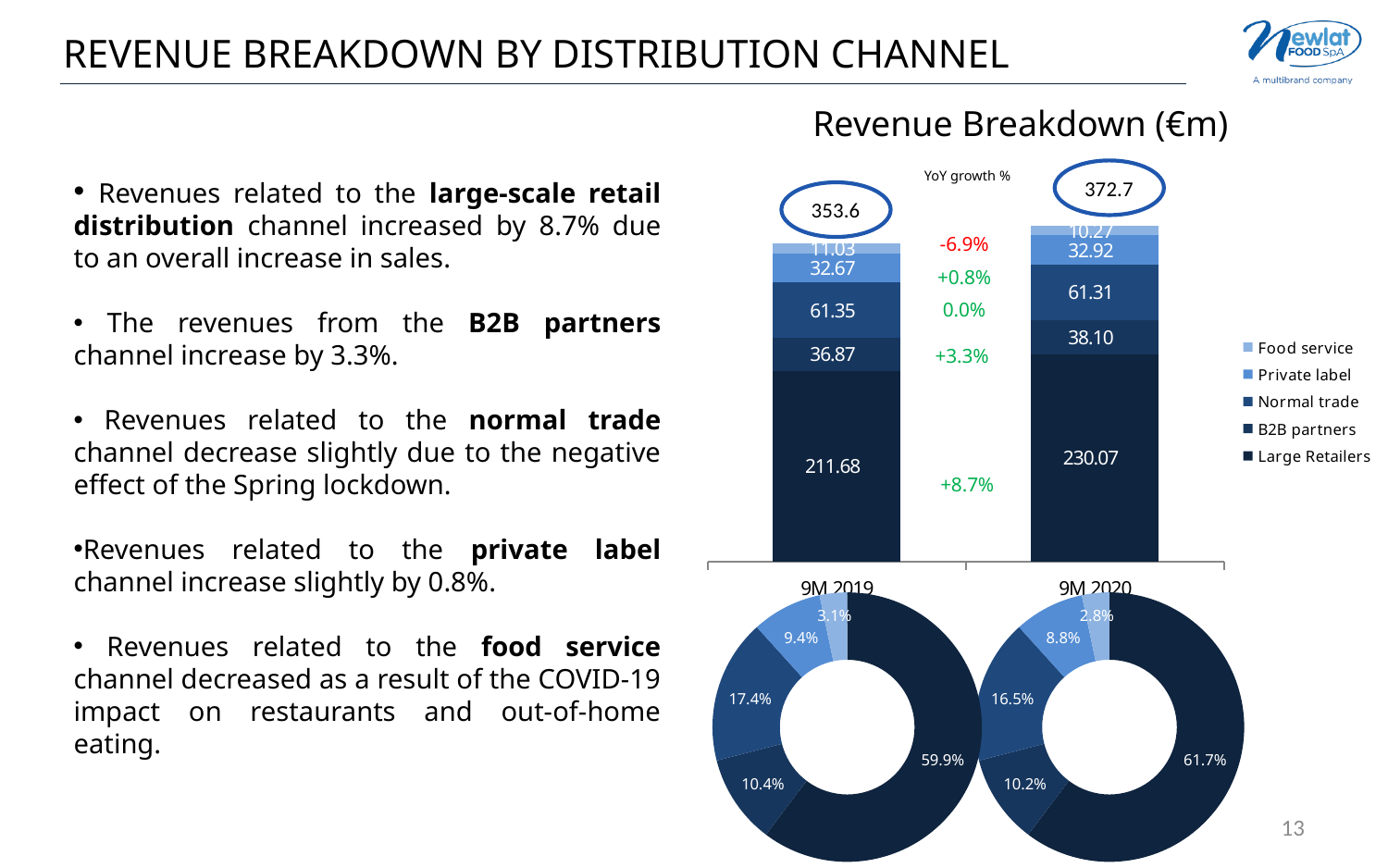
In the right donut chart (9M 2020), what share does the smallest slice have? 2.8% In the left donut chart (9M 2019), what share does the largest slice have? 59.9% In the Revenue Breakdown (€m) stacked bar chart, is the Private label value larger in 9M 2019 or 9M 2020? 9M 2020 In the Revenue Breakdown (€m) stacked bar chart, what is the total of the 9M 2019 bar? 353.6 In the Revenue Breakdown (€m) stacked bar chart, which segment is the smallest in the 9M 2019 bar? Food service In the Revenue Breakdown (€m) stacked bar chart, what is the total of the 9M 2020 bar? 372.7 In the Revenue Breakdown (€m) stacked bar chart, what is the value for Food service in 9M 2020? 10.27 In the Revenue Breakdown (€m) stacked bar chart, what is the difference between the B2B partners values for 9M 2020 and 9M 2019? 1.23 How many series does the legend of the Revenue Breakdown (€m) chart list? 5 In the Revenue Breakdown (€m) stacked bar chart, what is the value for Large Retailers in 9M 2020? 230.07 In the Revenue Breakdown (€m) stacked bar chart, what is the value for Normal trade in 9M 2019? 61.35 In the Revenue Breakdown (€m) stacked bar chart, which segment is the largest in the 9M 2020 bar? Large Retailers